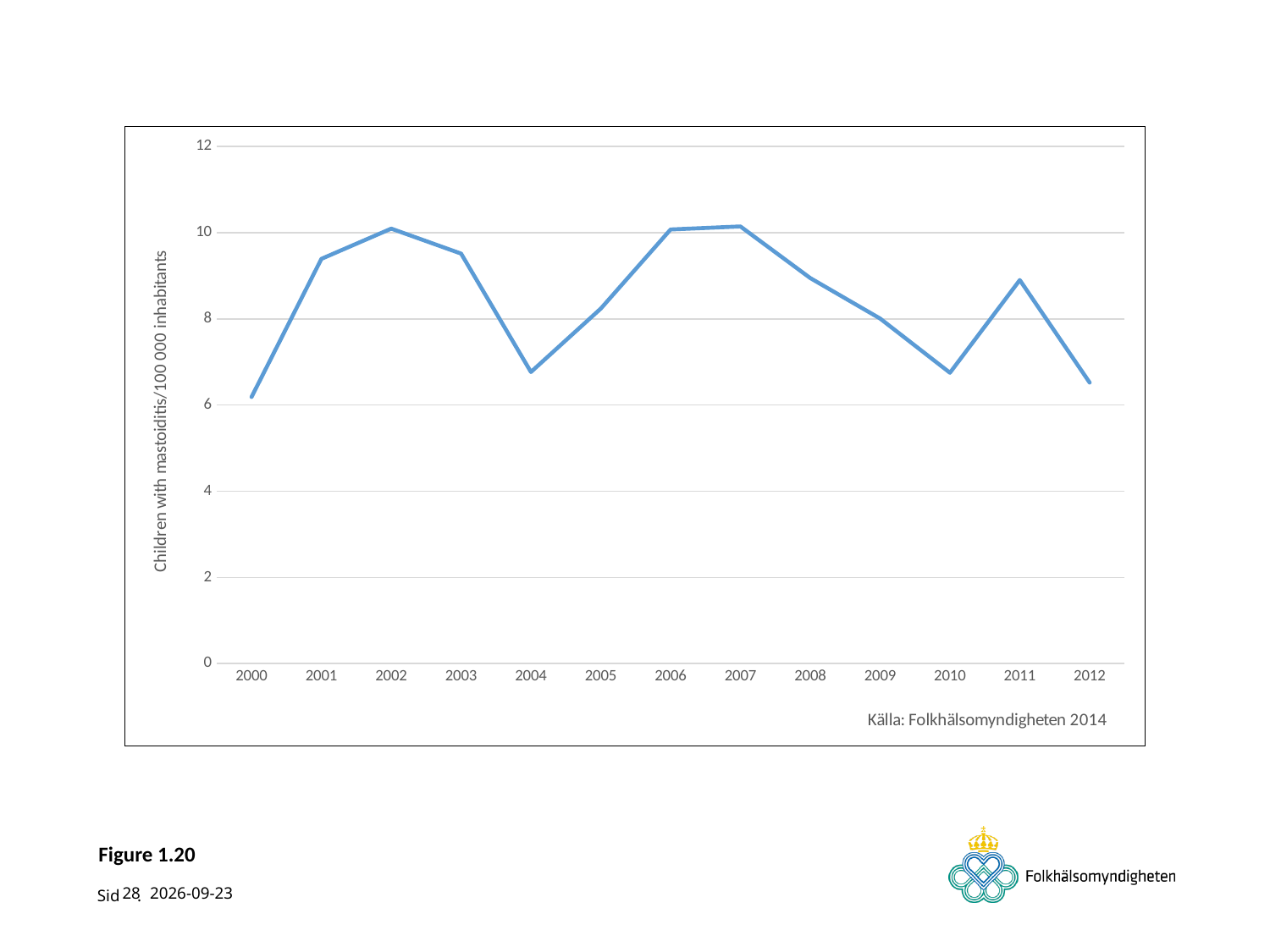
Which year has the larger value, 2001 or 2004? 2001 Is the value for 2000 greater or less than 8? less What kind of chart is shown on the slide? line chart Do the values rise or fall from 2007 to 2010? fall Is the value for 2012 greater or less than 8? less Which year has the larger value, 2010 or 2011? 2011 How many years are plotted along the x axis? 13 What is the label on the y axis? Children with mastoiditis/100 000 inhabitants Is the value for 2002 greater or less than 8? greater Do the values rise or fall from 2000 to 2002? rise